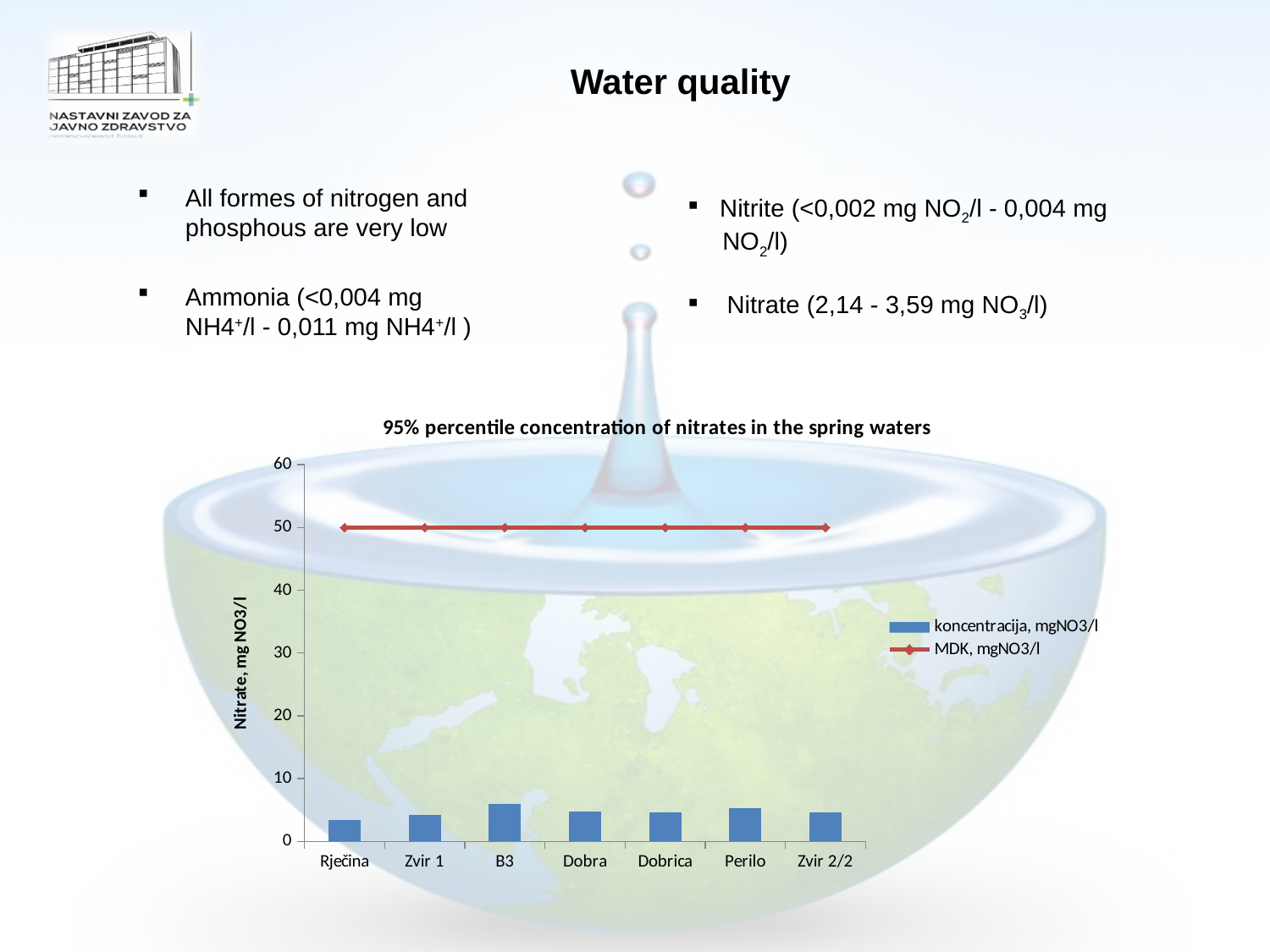
How many spring water sites are shown on the x axis of the chart? 7 What is the value of the MDK, mgNO3/l line across all sites? 50 What is the label of the y axis of the chart? Nitrate, mg NO3/l How many series does the chart legend list? 2 Is the nitrate concentration for B3 greater or less than 10? less Which is larger, the nitrate concentration for B3 or for Rječina? B3 Is the MDK value for Dobra greater or less than 40? greater Which site has the highest nitrate concentration bar? B3 Which site has the lowest nitrate concentration bar? Rječina What is the title of the chart? 95% percentile concentration of nitrates in the spring waters What kind of chart is shown on the slide? bar chart with a line Which is larger, the nitrate concentration for Perilo or for Zvir 1? Perilo